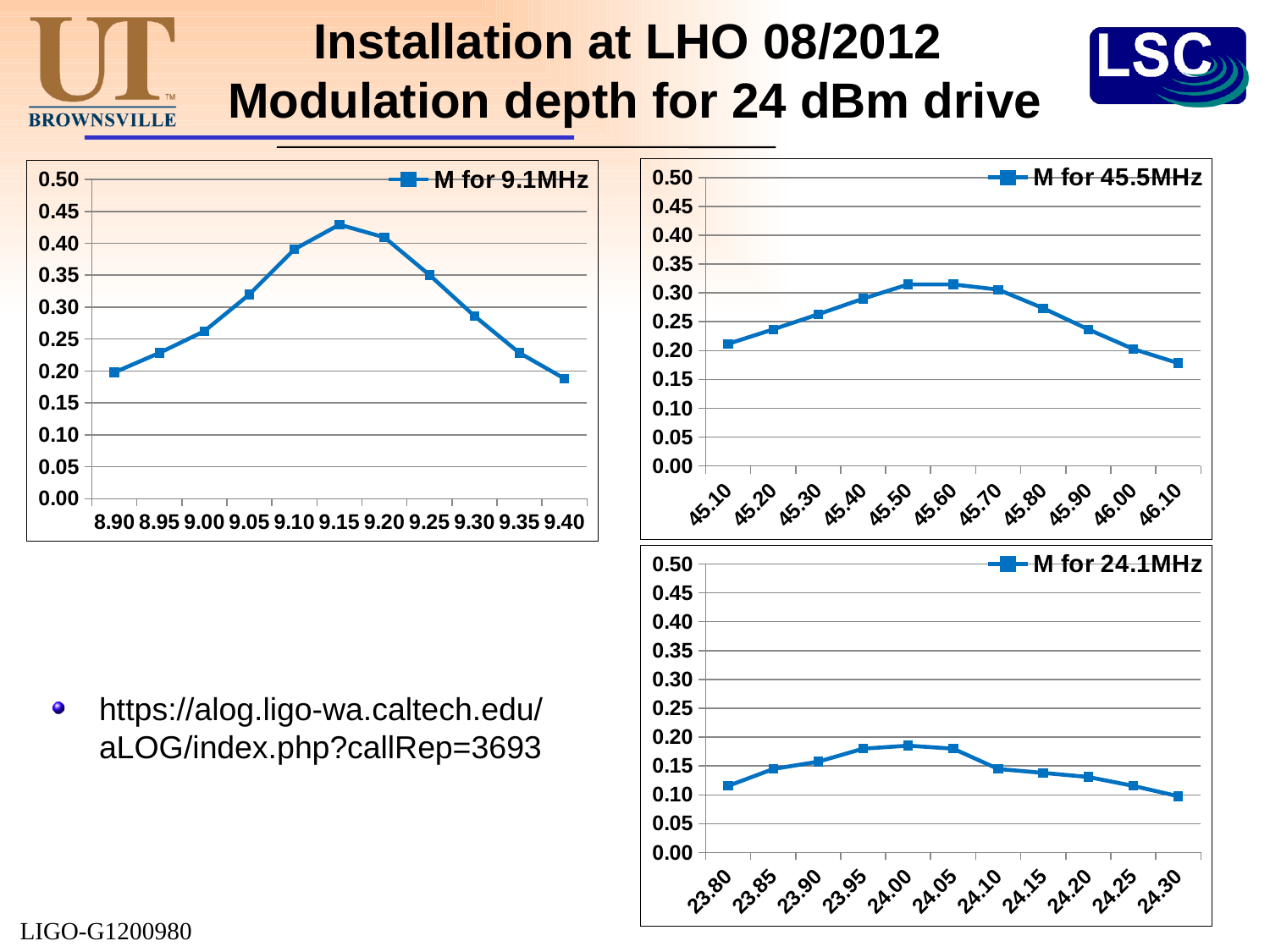
In the 'M for 9.1MHz' chart, do the values rise or fall from 9.15 to 9.40? fall In the 'M for 9.1MHz' chart, is the value at 9.15 greater or less than 0.40? greater In the 'M for 24.1MHz' chart, is the value at 24.00 greater or less than 0.20? less In the 'M for 9.1MHz' chart, is the value at 9.15 larger or smaller than the value at 9.25? larger How many series does the legend of the 'M for 45.5MHz' chart list? 1 How many data points are plotted in the 'M for 9.1MHz' chart? 11 What type of chart is the 'M for 9.1MHz' chart? line chart In the 'M for 9.1MHz' chart, at which x value is the modulation depth highest? 9.15 In the 'M for 45.5MHz' chart, is the value at 45.80 greater or less than 0.25? greater In the 'M for 24.1MHz' chart, do the values rise or fall from 23.80 to 24.00? rise In the 'M for 45.5MHz' chart, is the value at 45.50 larger or smaller than the value at 46.10? larger